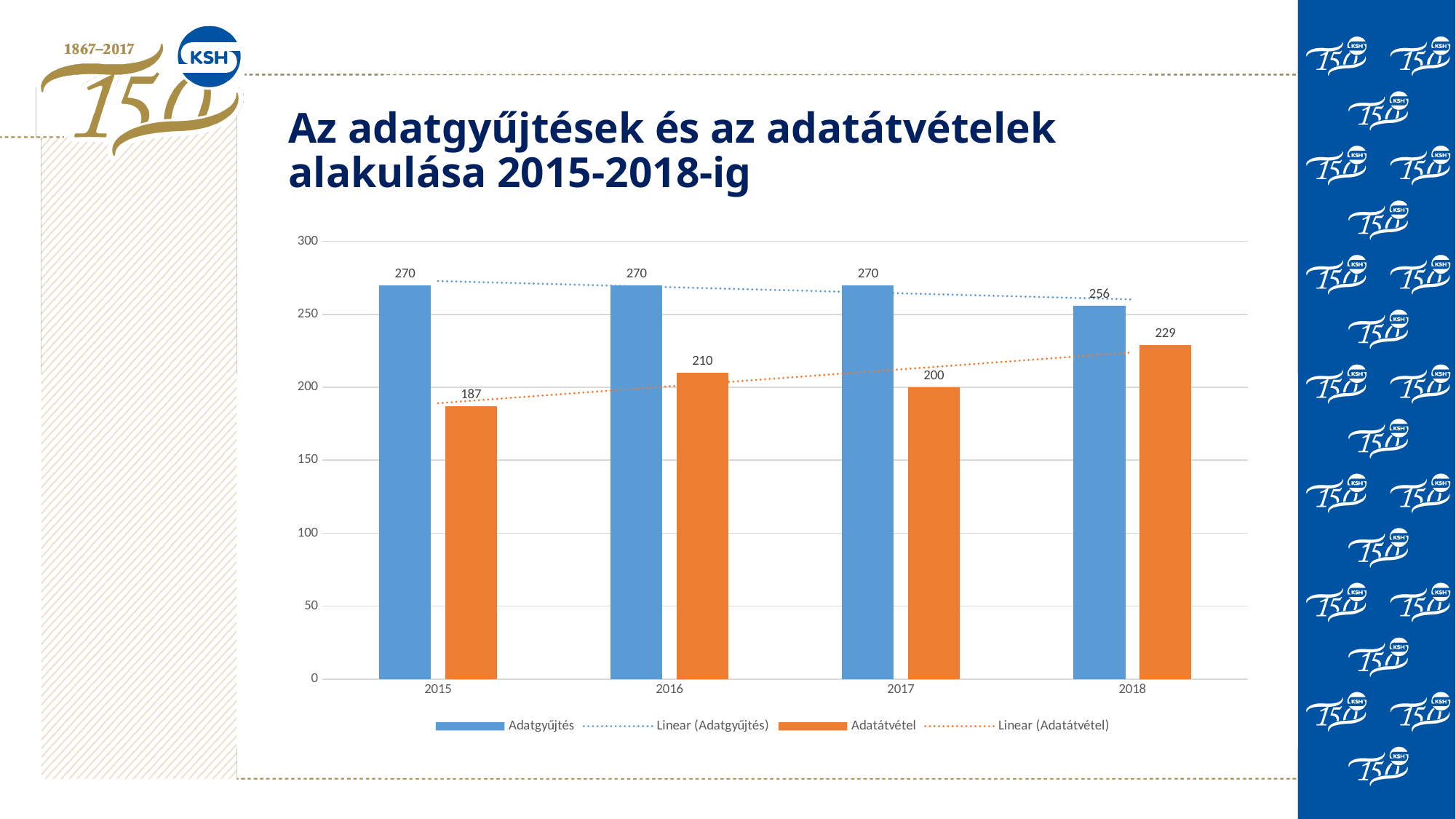
What is the value of Adatátvétel in 2016? 210 Which is larger in 2017, Adatgyűjtés or Adatátvétel? Adatgyűjtés What is the value of Adatgyűjtés in 2015? 270 What is the value of Adatátvétel in 2018? 229 What kind of chart is shown on the slide? Bar chart In which year is Adatátvétel lowest? 2015 How many entries does the legend list? 4 What is the difference between Adatgyűjtés and Adatátvétel in 2018? 27 How many years are shown on the x axis? 4 In which year is Adatgyűjtés lowest? 2018 What is the difference between Adatgyűjtés and Adatátvétel in 2015? 83 In which year is Adatátvétel highest? 2018